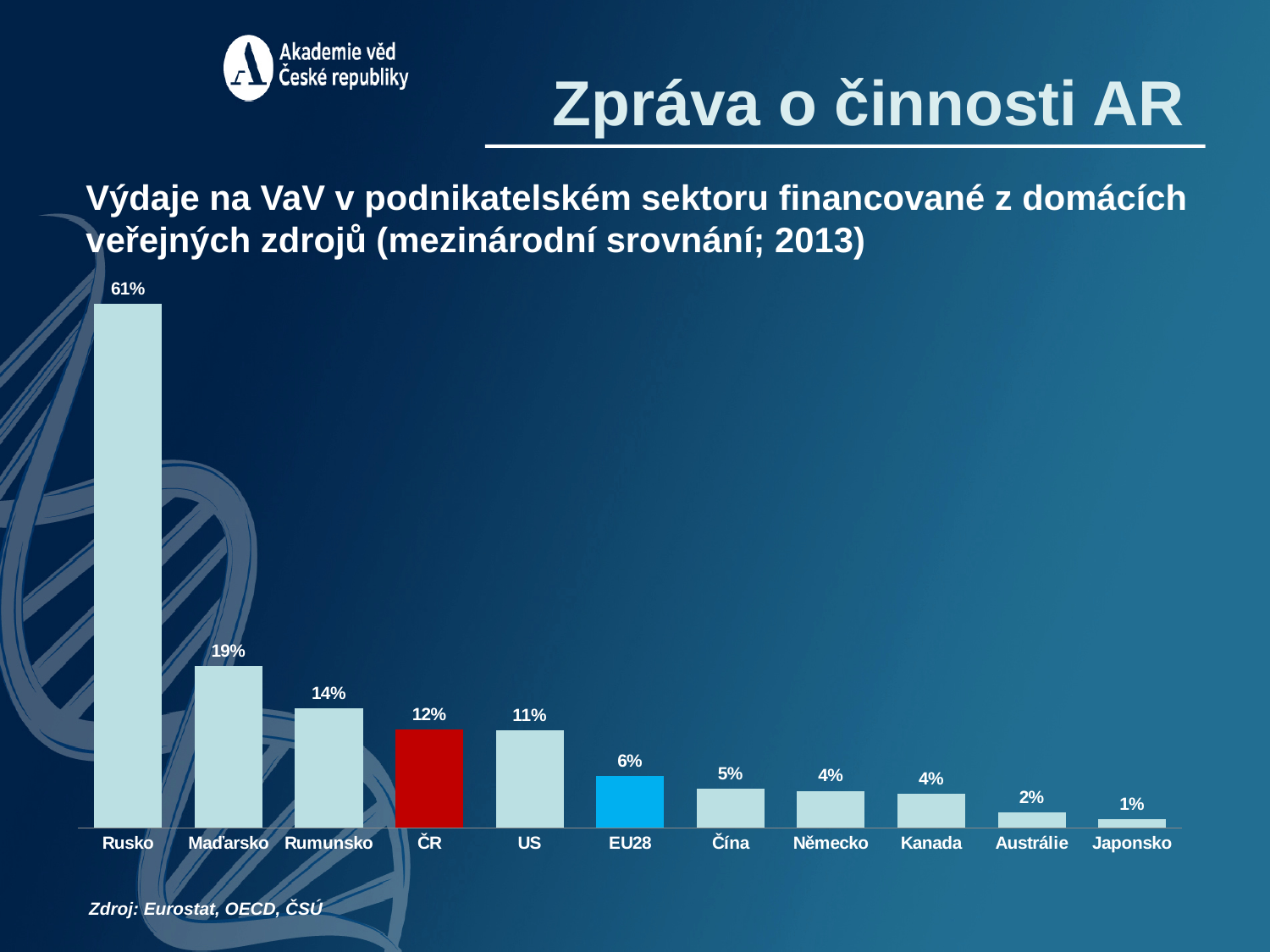
What is the difference between the values for ČR and EU28? 6% What is the value for EU28? 6% What is the value for ČR? 12% Which bar is coloured red? ČR How many countries or regions are shown on the chart? 11 Which country has the lowest value? Japonsko What is the difference between the values for Maďarsko and Rumunsko? 5% Which country has the highest value? Rusko Which is larger, the value for US or the value for Čína? US Do the values rise or fall from left to right along the x axis? fall What is the value for Rusko? 61% What kind of chart is shown on the slide? bar chart